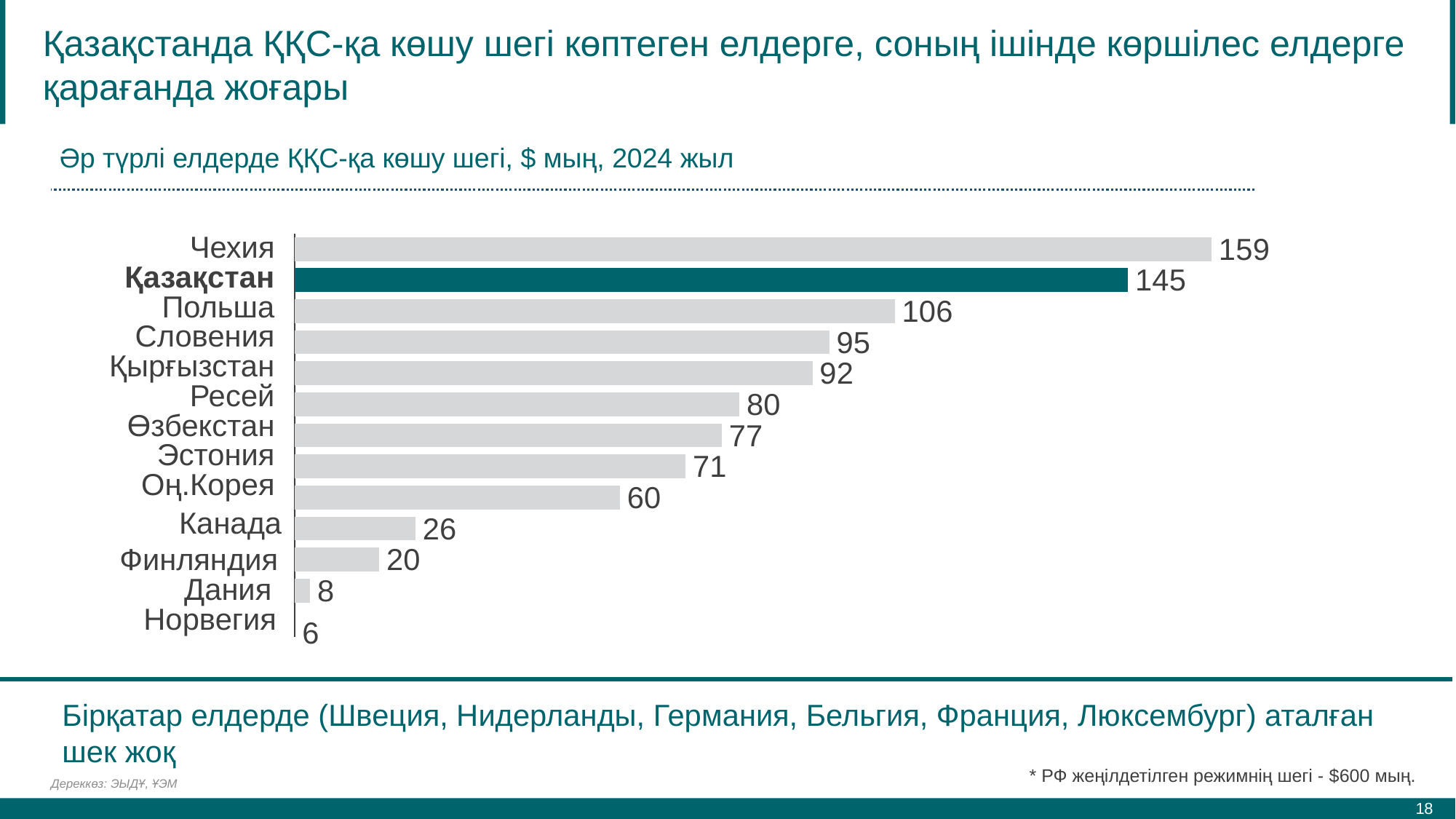
What is the difference between the values for Қазақстан and Ресей? 65 What is the title of the chart? Әр түрлі елдерде ҚҚС-қа көшу шегі, $ мың, 2024 жыл What is the value for Қазақстан? 145 What is the value for Финляндия? 20 Which country has the highest value? Чехия Which is larger, the value for Словения or the value for Өзбекстан? Словения What is the difference between the values for Чехия and Қазақстан? 14 What kind of chart is shown on the slide? Bar chart What is the value for Польша? 106 How many countries are shown in the chart? 13 What is the value for Қырғызстан? 92 Which country has the lowest value? Норвегия